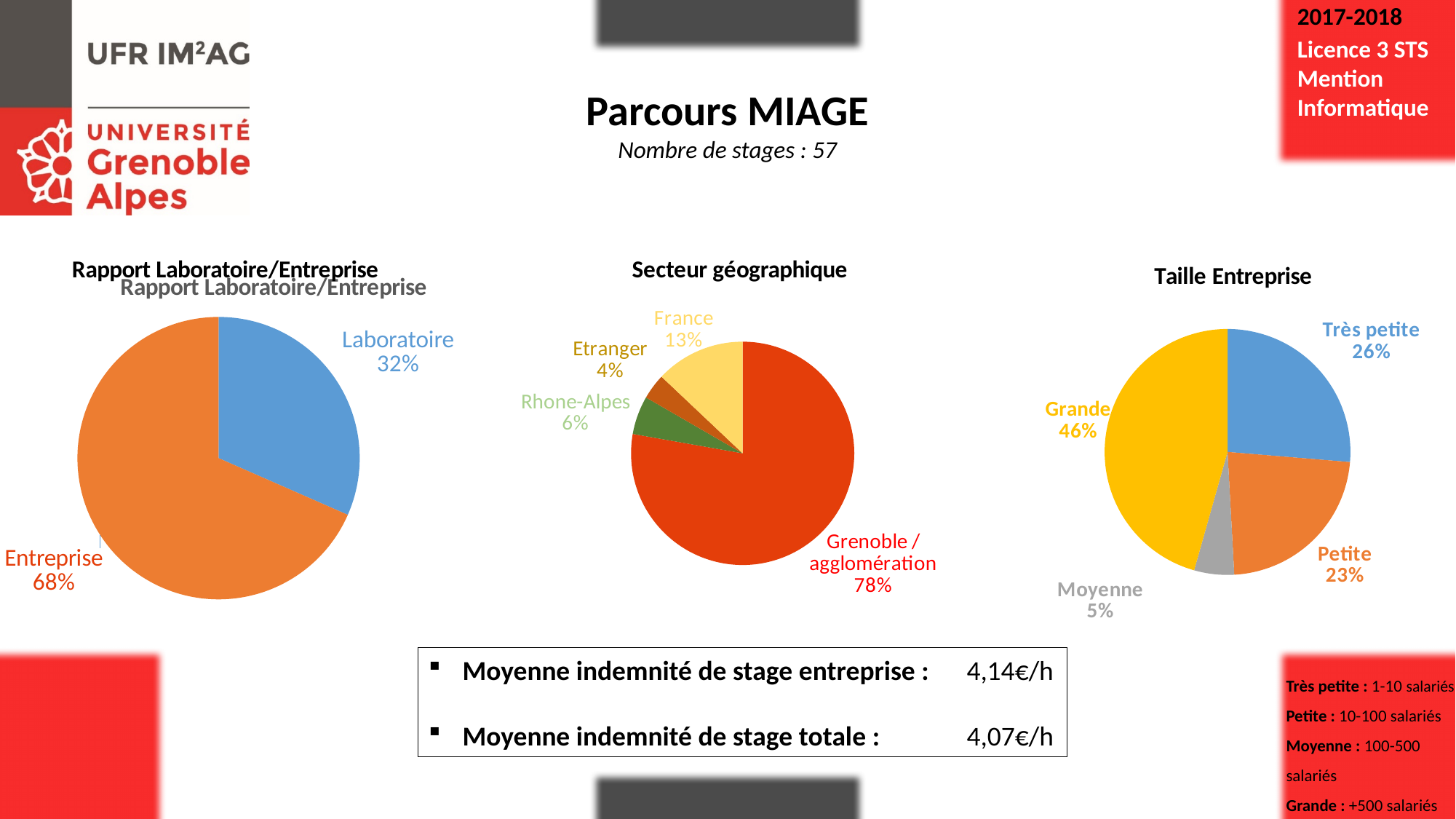
In the 'Secteur géographique' chart, which is larger, France or Rhone-Alpes? France In the 'Secteur géographique' chart, which category has the smallest share? Etranger What type of chart is the 'Taille Entreprise' chart? Pie chart In the 'Rapport Laboratoire/Entreprise' chart, what is the difference between the Entreprise and Laboratoire shares? 36% In the 'Taille Entreprise' chart, what share does Grande have? 46% In the 'Taille Entreprise' chart, how many categories are shown? 4 In the 'Taille Entreprise' chart, what is the difference between the Très petite and Petite shares? 3% In the 'Taille Entreprise' chart, which category has the largest share? Grande In the 'Secteur géographique' chart, how many categories are shown? 4 In the 'Secteur géographique' chart, what share does Grenoble / agglomération have? 78% In the 'Rapport Laboratoire/Entreprise' chart, what share does Entreprise have? 68% In the 'Rapport Laboratoire/Entreprise' chart, what share does Laboratoire have? 32%